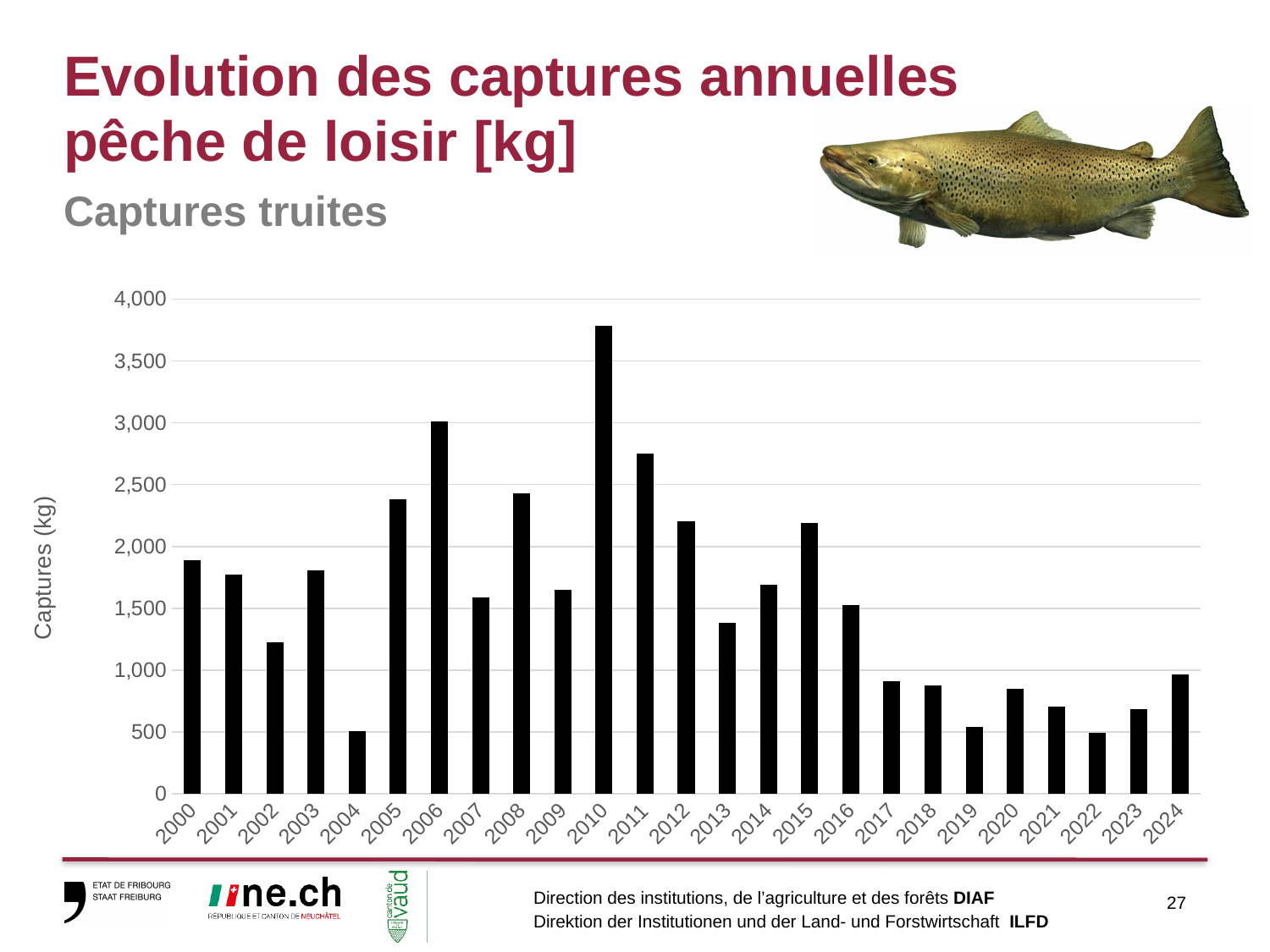
Is the value for 2006 greater or less than 2,500? greater Is the value for 2013 greater or less than 1,500? less Do the values rise or fall from 2010 to 2013? fall Which year has the highest catch value in the chart? 2010 Is the value for 2010 greater or less than 3,500? greater What is the label on the y axis of the chart? Captures (kg) What kind of chart is shown on the slide? bar chart Which year has the larger value, 2006 or 2010? 2010 How many years are shown on the x axis of the chart? 25 Which year has the larger value, 2016 or 2017? 2016